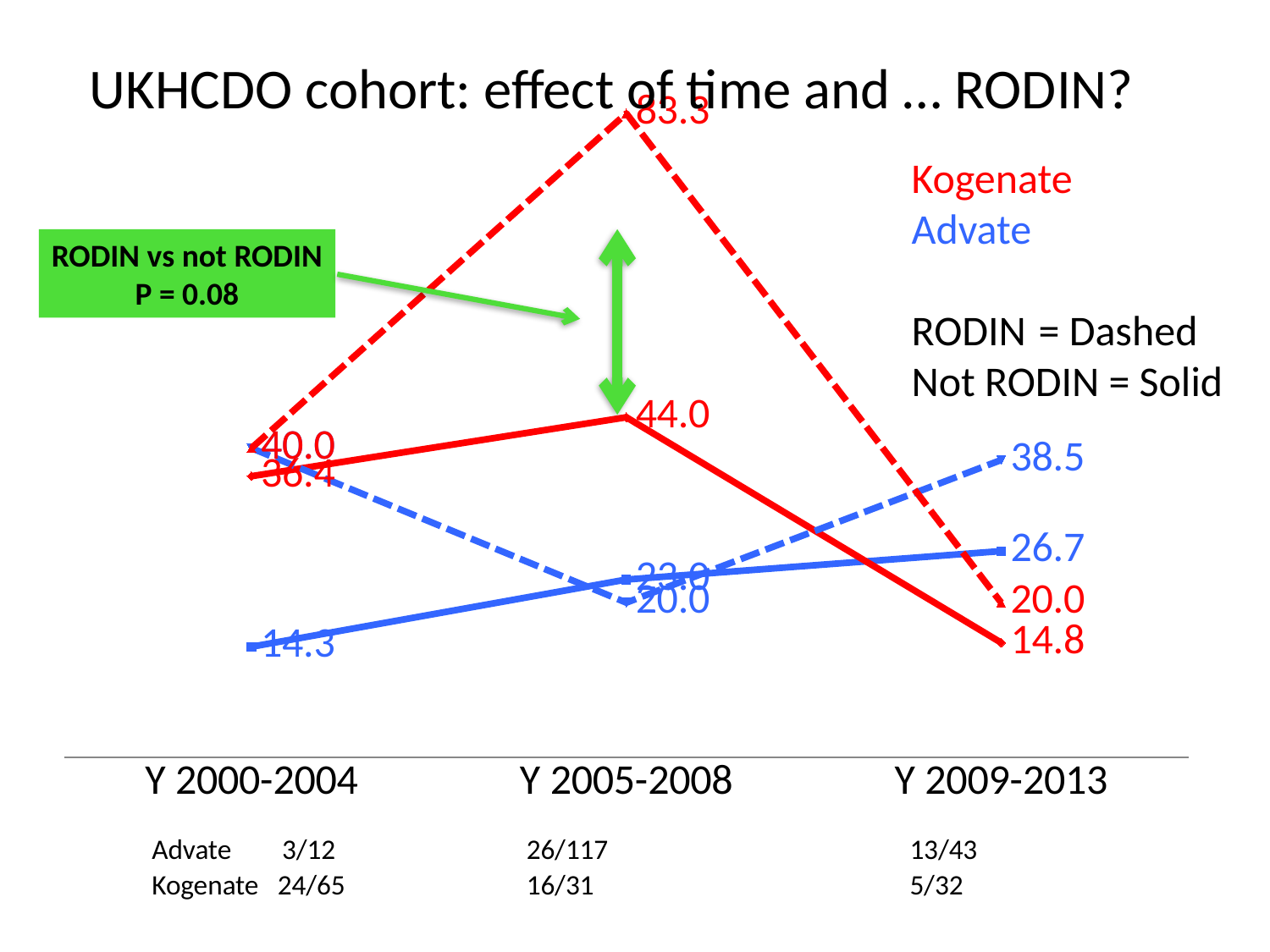
What is the value of the dashed Kogenate (RODIN) line at Y 2005-2008? 83.3 How many time periods are shown along the x axis? 3 What is the value of the solid Kogenate (Not RODIN) line at Y 2005-2008? 44.0 At Y 2009-2013, which Advate line is higher, the dashed (RODIN) or the solid (Not RODIN)? Dashed (RODIN) What is the value of the solid Kogenate (Not RODIN) line at Y 2009-2013? 14.8 What P value is given for RODIN vs not RODIN? P = 0.08 Which period has the highest value on the dashed Kogenate (RODIN) line? Y 2005-2008 What is the value of the solid Advate (Not RODIN) line at Y 2000-2004? 14.3 What type of chart is shown on the slide? Line chart What is the value of the dashed Advate (RODIN) line at Y 2009-2013? 38.5 What is the difference between the dashed and solid Kogenate values at Y 2005-2008? 39.3 Does the solid Advate (Not RODIN) line rise or fall from Y 2000-2004 to Y 2009-2013? Rise